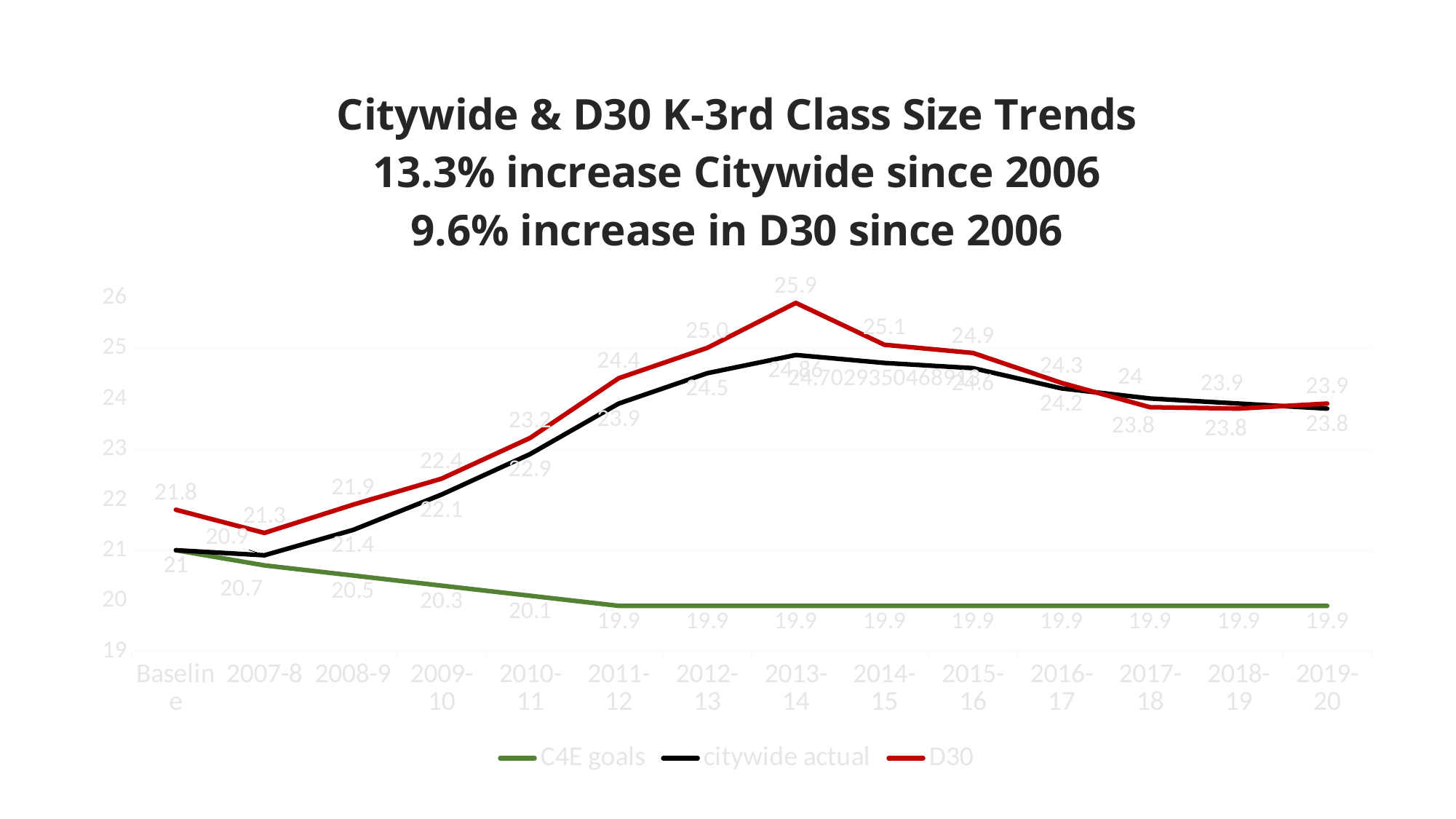
How many series does the legend list? 3 Do the C4E goals values rise or fall from Baseline to 2011-12? fall What is the difference between the D30 value and the citywide actual value in 2011-12? 0.5 In which year is the D30 value highest? 2013-14 What is the D30 value for 2013-14? 25.9 What is the citywide actual value for 2010-11? 22.9 Which is larger in 2012-13, the D30 value or the citywide actual value? D30 In which year is the D30 value lowest? 2007-8 What kind of chart is shown on the slide? line chart What colour is the D30 line? red How many categories are shown along the x axis? 14 What is the C4E goals value for 2019-20? 19.9